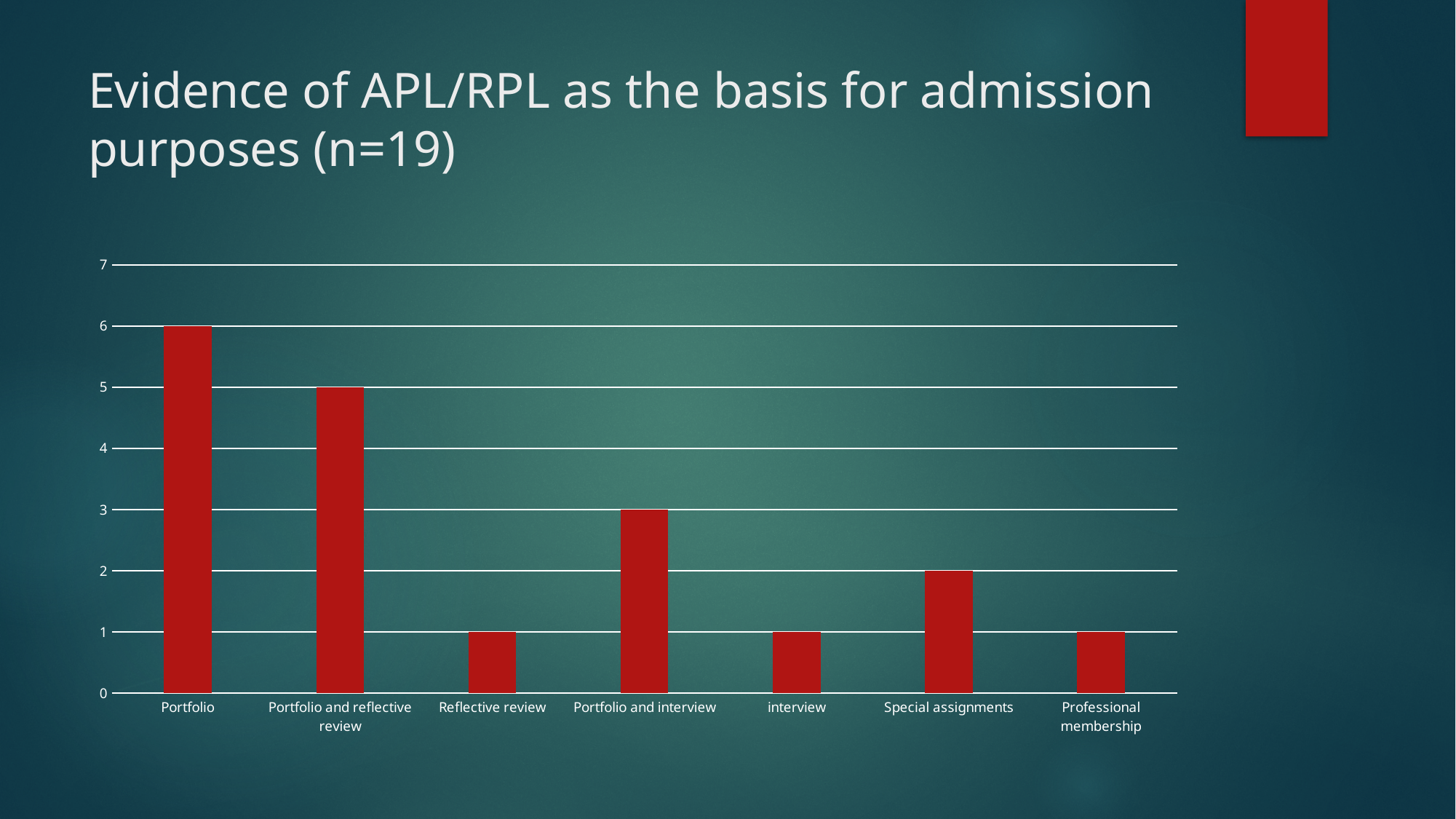
What is the value for Portfolio? 6 What is the value for Portfolio and reflective review? 5 Which category has the highest value? Portfolio What type of chart is shown on the slide? Bar chart What is the value for Special assignments? 2 Is the value for Portfolio and reflective review greater or less than 4? greater What colour are the bars in the chart? Red How many categories are shown on the x axis? 7 What is the title of the chart on the slide? Evidence of APL/RPL as the basis for admission purposes (n=19) What is the difference between the values for Portfolio and Portfolio and interview? 3 Which is larger, the value for Special assignments or the value for Reflective review? Special assignments What is the value for Portfolio and interview? 3